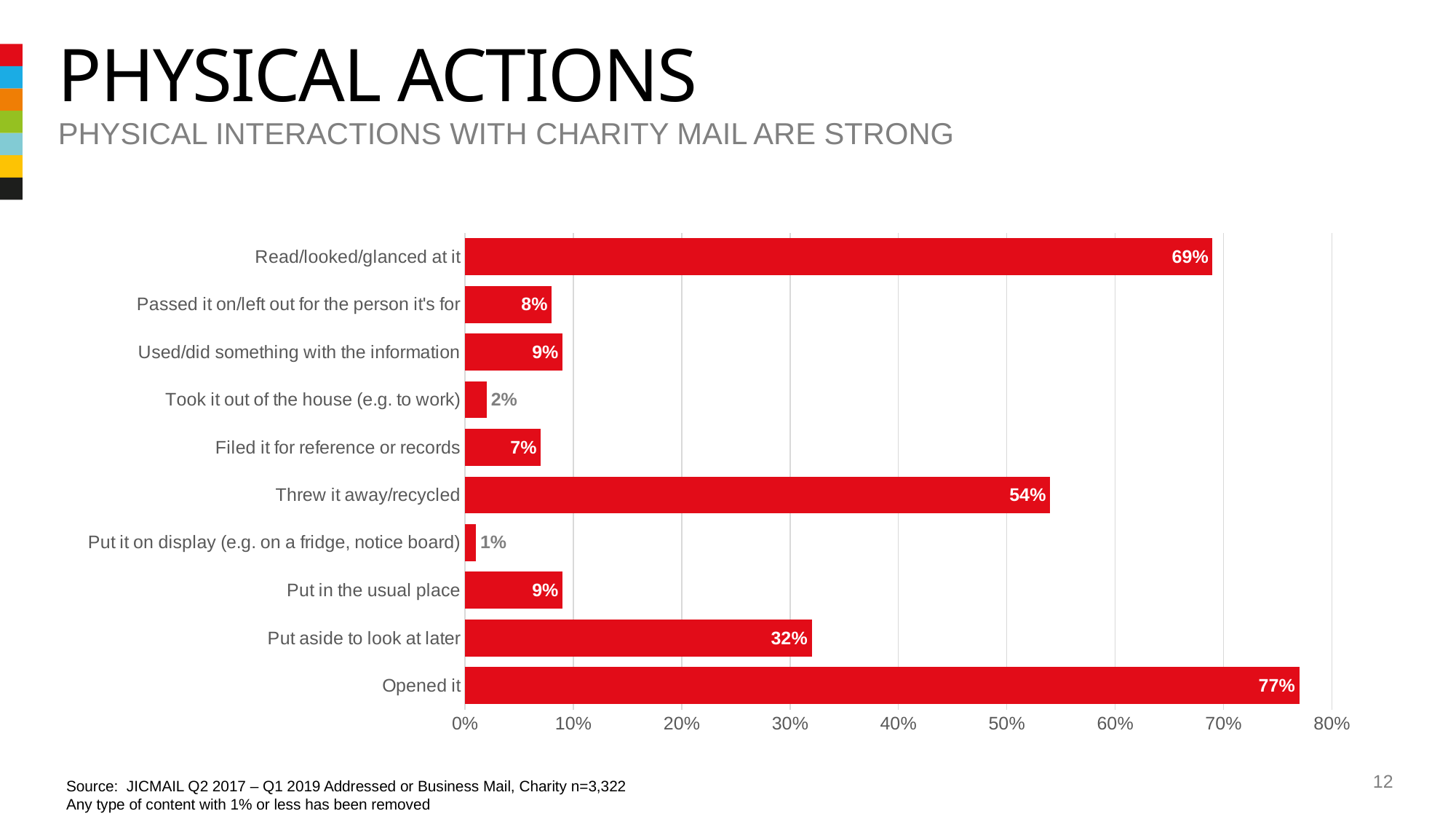
What is the subtitle of the slide? PHYSICAL INTERACTIONS WITH CHARITY MAIL ARE STRONG Is the value for 'Threw it away/recycled' greater or less than 50%? greater What is the difference between 'Opened it' and 'Threw it away/recycled'? 23% What percentage of respondents read/looked/glanced at the charity mail? 69% Which physical action has the lowest value? Put it on display (e.g. on a fridge, notice board) What is the value for 'Filed it for reference or records'? 7% What is the value for 'Opened it'? 77% Which is larger: 'Passed it on/left out for the person it's for' or 'Used/did something with the information'? Used/did something with the information How many physical actions are shown in the chart? 10 Which physical action has the highest value? Opened it What type of chart is shown on the slide? Bar chart What is the value for 'Put aside to look at later'? 32%